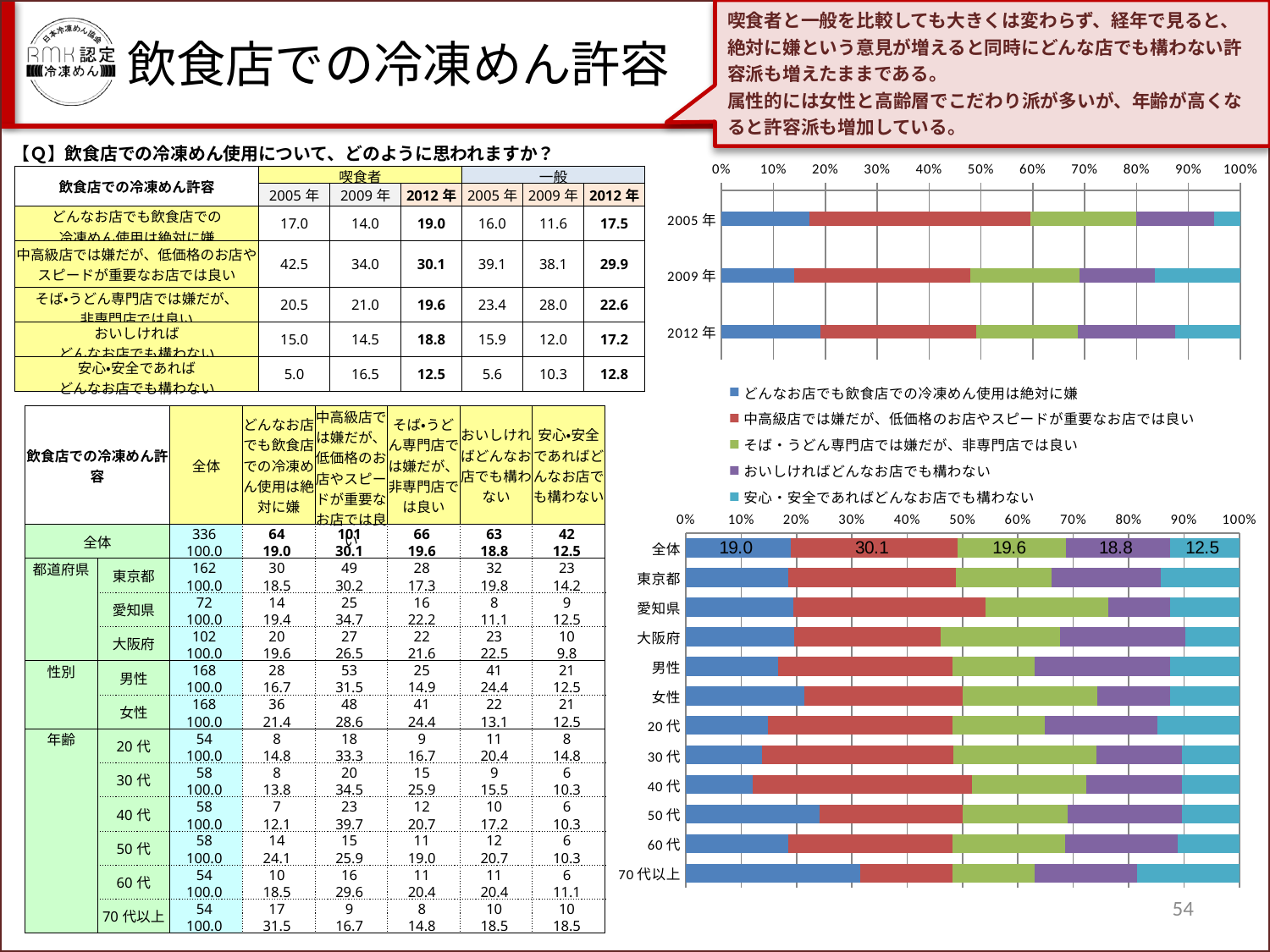
In the top-right chart, is the value of the blue segment (どんなお店でも飲食店での冷凍めん使用は絶対に嫌) for 2009年 greater or less than 20%? less In the bottom-right chart, what is the total of the five labelled segments of the 全体 bar? 100.0 In the bottom-right chart, what is the value labelled on the 全体 bar for 中高級店では嫌だが、低価格のお店やスピードが重要なお店では良い? 30.1 In the bottom-right chart, which segment of the 全体 bar has the largest value? 中高級店では嫌だが、低価格のお店やスピードが重要なお店では良い In the bottom-right chart, what is the value labelled on the 全体 bar for 安心・安全であればどんなお店でも構わない? 12.5 What kind of chart is the bottom-right chart (the one with 全体 at the top)? stacked bar chart In the bottom-right chart, what is the difference between the 全体 values for 中高級店では嫌だが、低価格のお店やスピードが重要なお店では良い (30.1) and 安心・安全であればどんなお店でも構わない (12.5)? 17.6 How many series does the legend between the two charts list? 5 In the bottom-right chart, how many categories are plotted on the vertical axis? 12 In the bottom-right chart, which segment of the 全体 bar has the smallest value? 安心・安全であればどんなお店でも構わない How many categories are plotted in the top-right chart? 3 In the bottom-right chart, is the blue segment (どんなお店でも飲食店での冷凍めん使用は絶対に嫌) larger for 70代以上 or for 40代? 70代以上